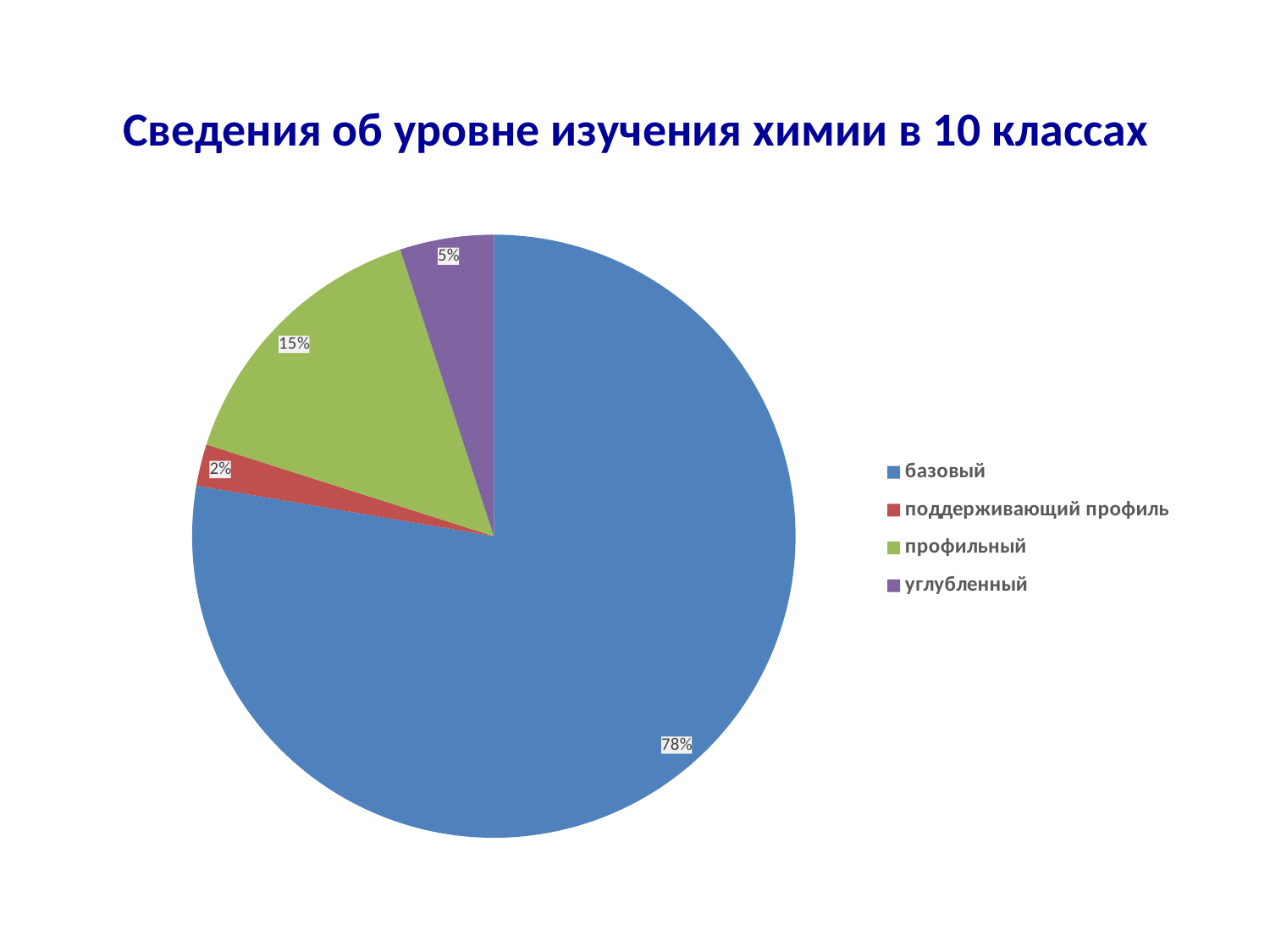
What share of the pie does the 'базовый' slice represent? 78% What share of the pie does the 'углубленный' slice represent? 5% What is the title of the slide? Сведения об уровне изучения химии в 10 классах What share of the pie does the 'поддерживающий профиль' slice represent? 2% What is the difference in percentage points between the 'базовый' and 'профильный' slices? 63 Which category has the smallest slice of the pie? поддерживающий профиль How many categories does the legend list? 4 Which slice is larger: 'профильный' or 'углубленный'? профильный Which category has the largest slice of the pie? базовый What type of chart is shown on the slide? pie chart What colour is the 'профильный' slice? green